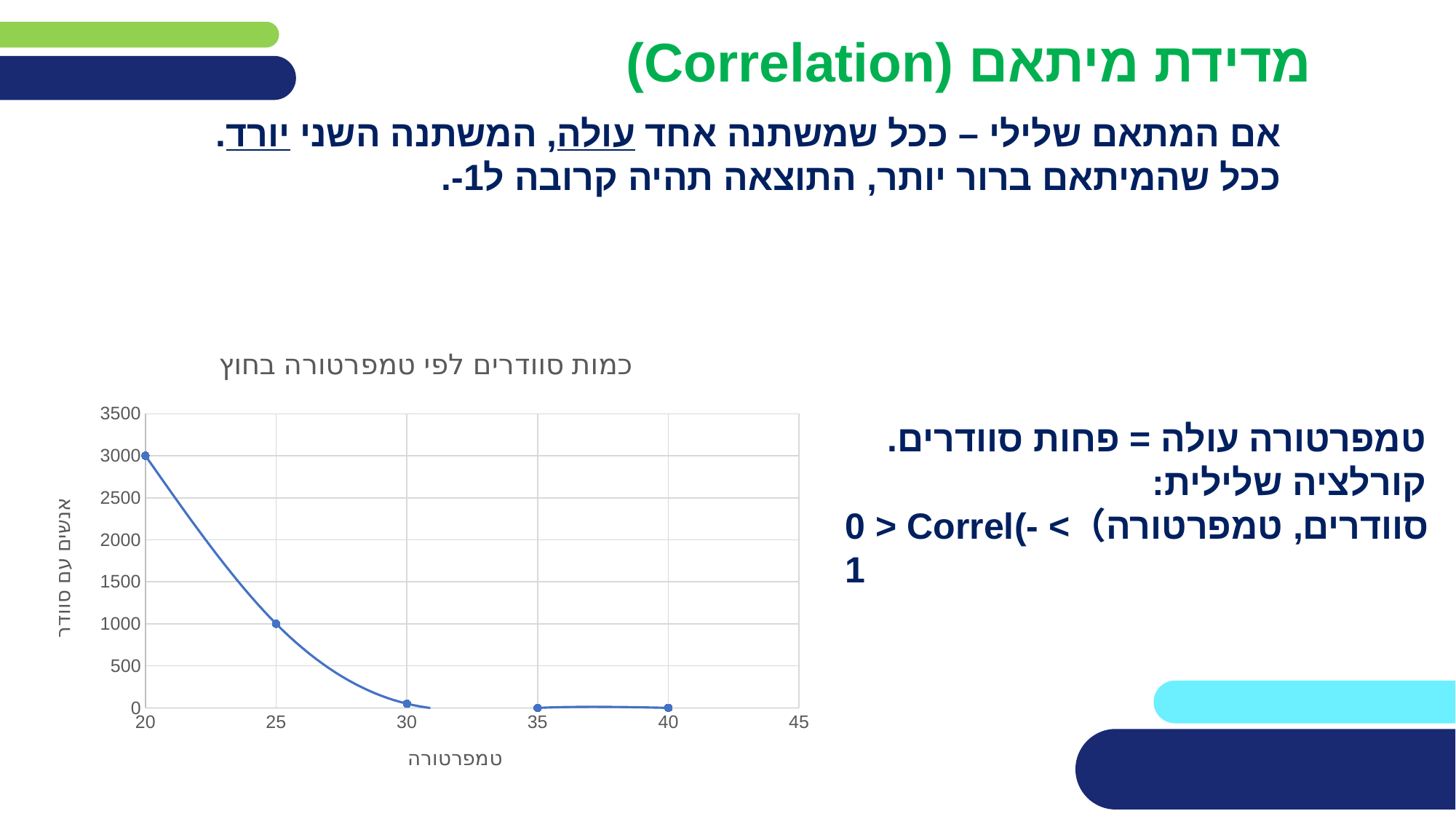
Is the value at temperature 25 greater or less than 1500? less Is the value at temperature 25 greater or less than 500? greater Is the value at temperature 30 greater or less than 500? less Which has a larger value, temperature 20 or temperature 25? 20 Do the values rise or fall as temperature increases along the x axis? fall What is the value at temperature 20? 3000 At which temperature is the number of people with sweaters highest? 20 What kind of chart is shown on the slide? line chart What is the title of the chart? כמות סוודרים לפי טמפרטורה בחוץ What is the label of the x axis? טמפרטורה How many data points are plotted on the chart? 5